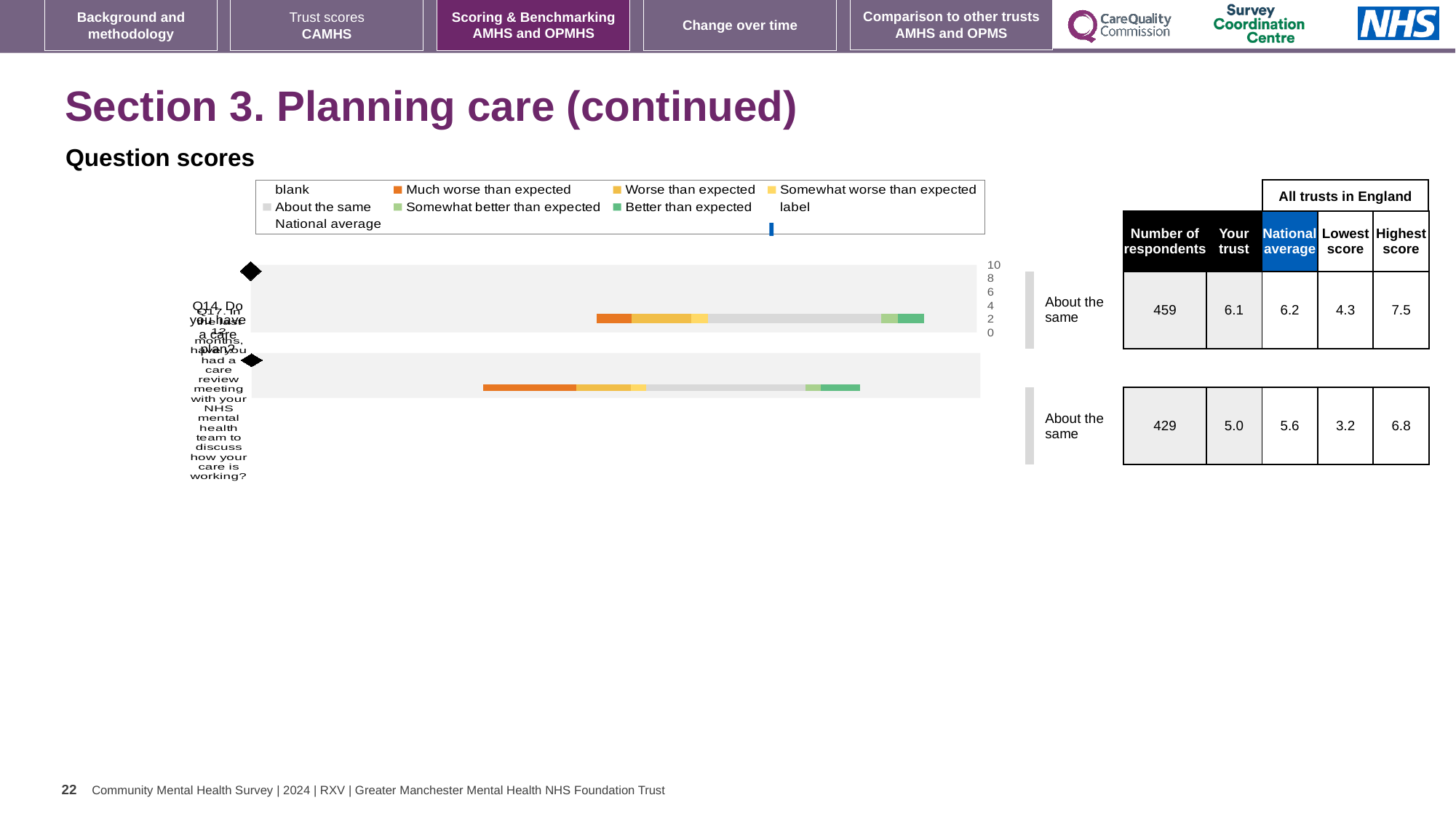
In the question scores chart legend, which category is shown in dark green? Better than expected What kind of chart is used to show the question scores on this slide? bar chart How many questions (bars) are plotted in the question scores chart? 2 In the question scores chart legend, which category is shown in orange? Much worse than expected What is the highest tick value shown on the axis of the question scores chart? 10